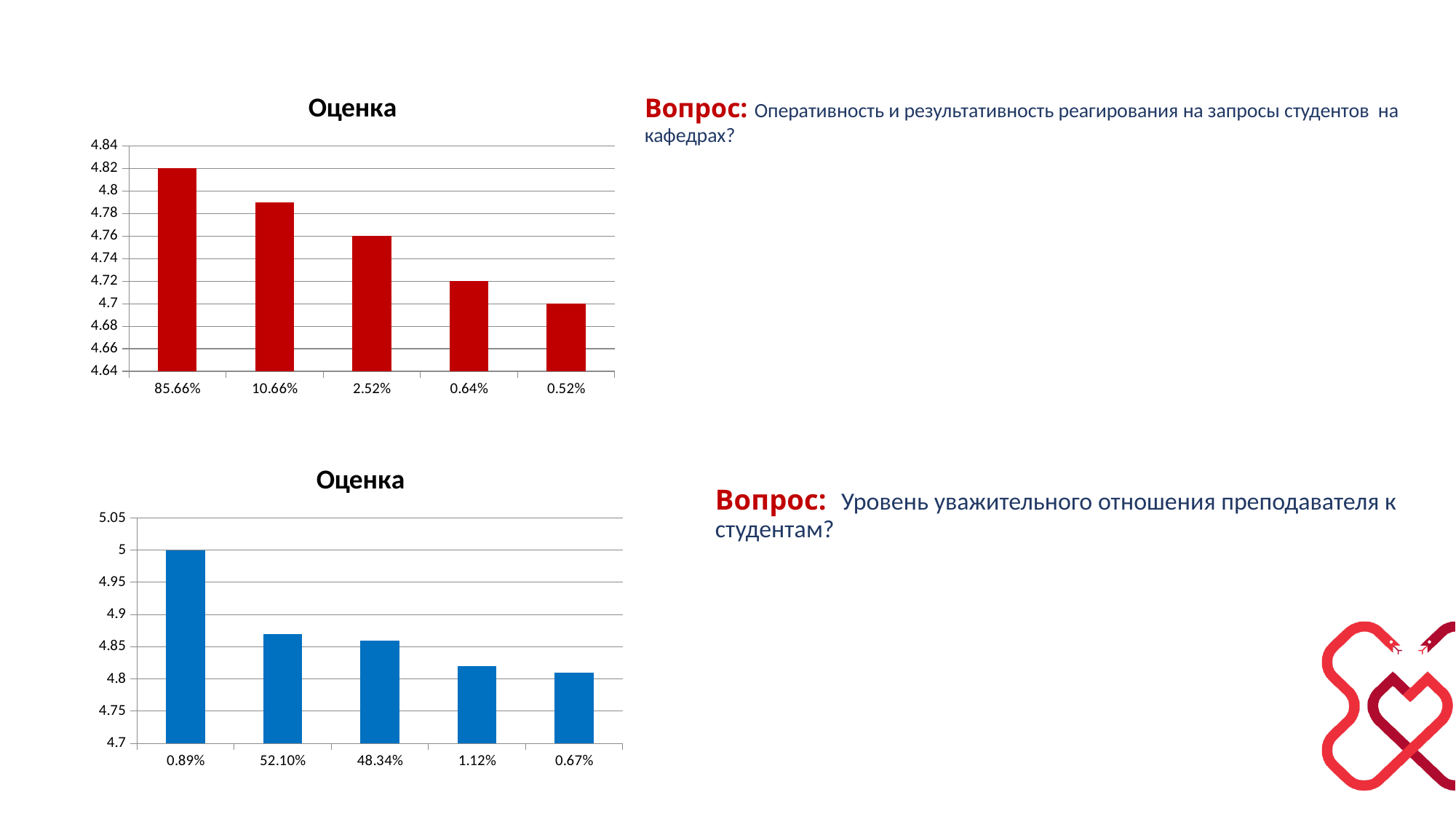
In the bottom chart, what is the value for the 0.89% category? 5 In the top chart, what is the value for the 0.52% category? 4.7 In the top chart, what is the value for the 2.52% category? 4.76 In the top chart, how many bars are plotted? 5 What type of chart is the bottom chart? bar chart In the top chart, which category has the highest value? 85.66% In the bottom chart, is the value for 52.10% greater or less than 4.9? less In the top chart, is the value for 10.66% greater or less than 4.78? greater In the bottom chart, which category has the lowest value? 0.67% In the top chart, what is the value for the 85.66% category? 4.82 In the top chart, what is the difference between the values for 85.66% and 0.64%? 0.1 In the bottom chart, do the values rise or fall from left to right along the x axis? fall